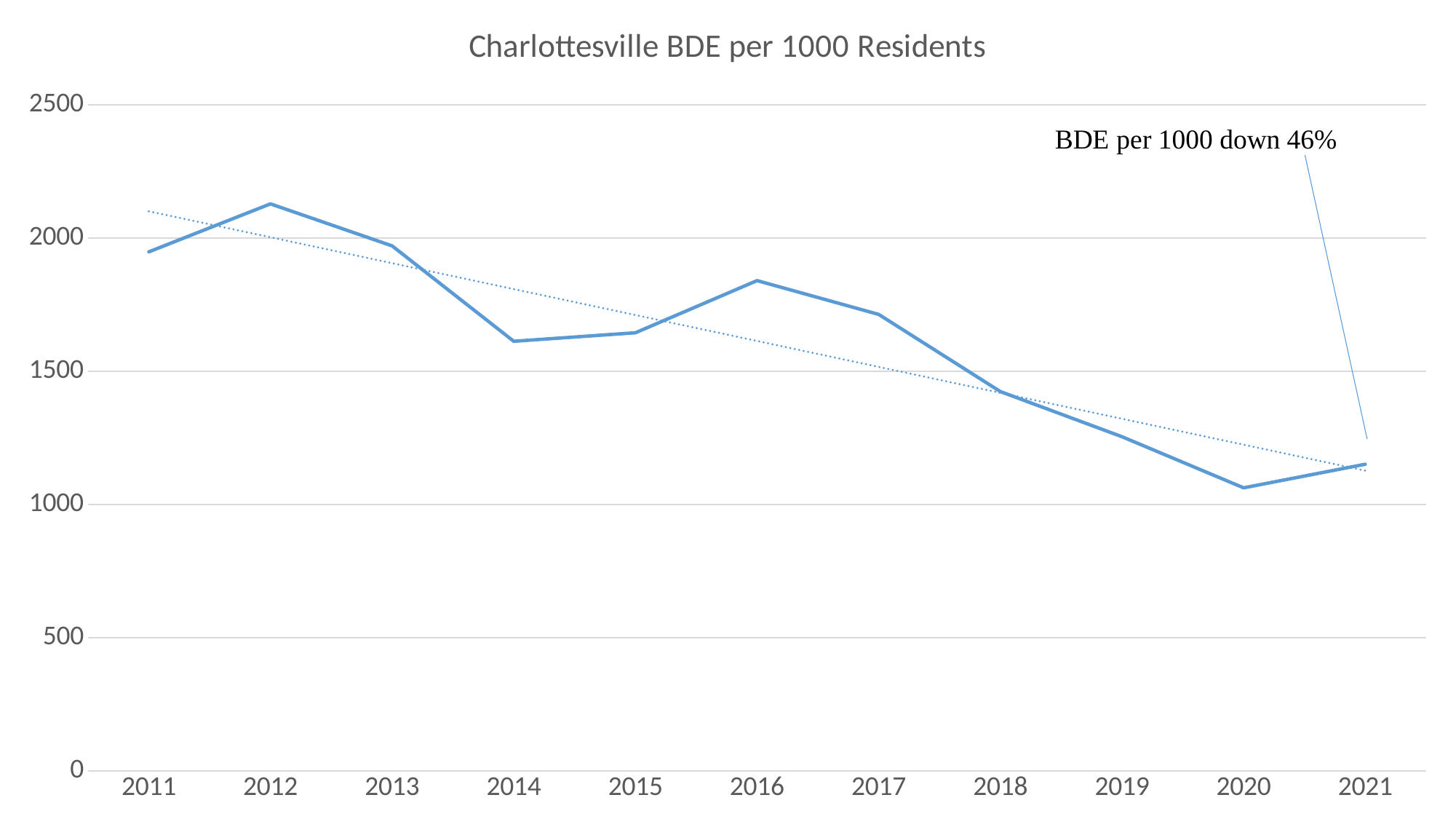
Is the value for 2016 greater or less than 1500? greater What kind of chart is shown on the slide? line chart Is the value for 2012 greater or less than 2000? greater Is the value for 2014 greater or less than 2000? less Which year has the lowest BDE per 1000 residents? 2020 How many years are plotted along the x axis? 11 What is the title of the chart? Charlottesville BDE per 1000 Residents Overall, do the values rise or fall from 2011 to 2021? fall What does the annotation on the chart say about the change in BDE per 1000? BDE per 1000 down 46% Which year has the highest BDE per 1000 residents? 2012 Which year has the larger value, 2016 or 2019? 2016